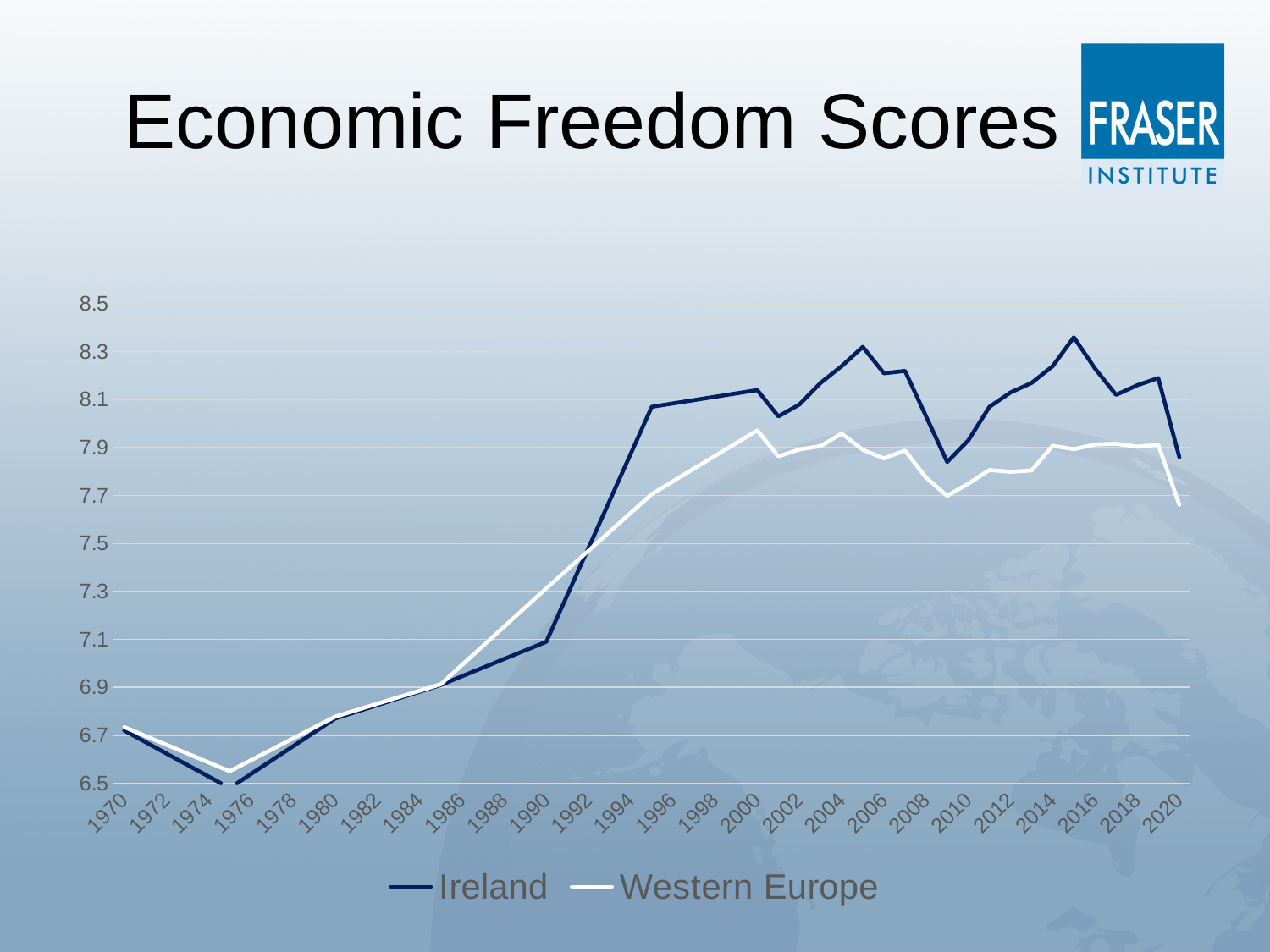
Is the value for Ireland in 1975 greater or less than 6.7? less Which series has the higher value in 2000, Ireland or Western Europe? Ireland Is the value for Western Europe in 2020 greater or less than 7.9? less Is the value for Ireland in 1990 greater or less than 7.3? less Which series has the higher value in 2020, Ireland or Western Europe? Ireland What kind of chart is shown on the slide? line chart What is the title of the chart? Economic Freedom Scores What are the two series named in the legend? Ireland and Western Europe Does the Ireland line rise or fall between 1976 and 1995? rise How many series does the legend list? 2